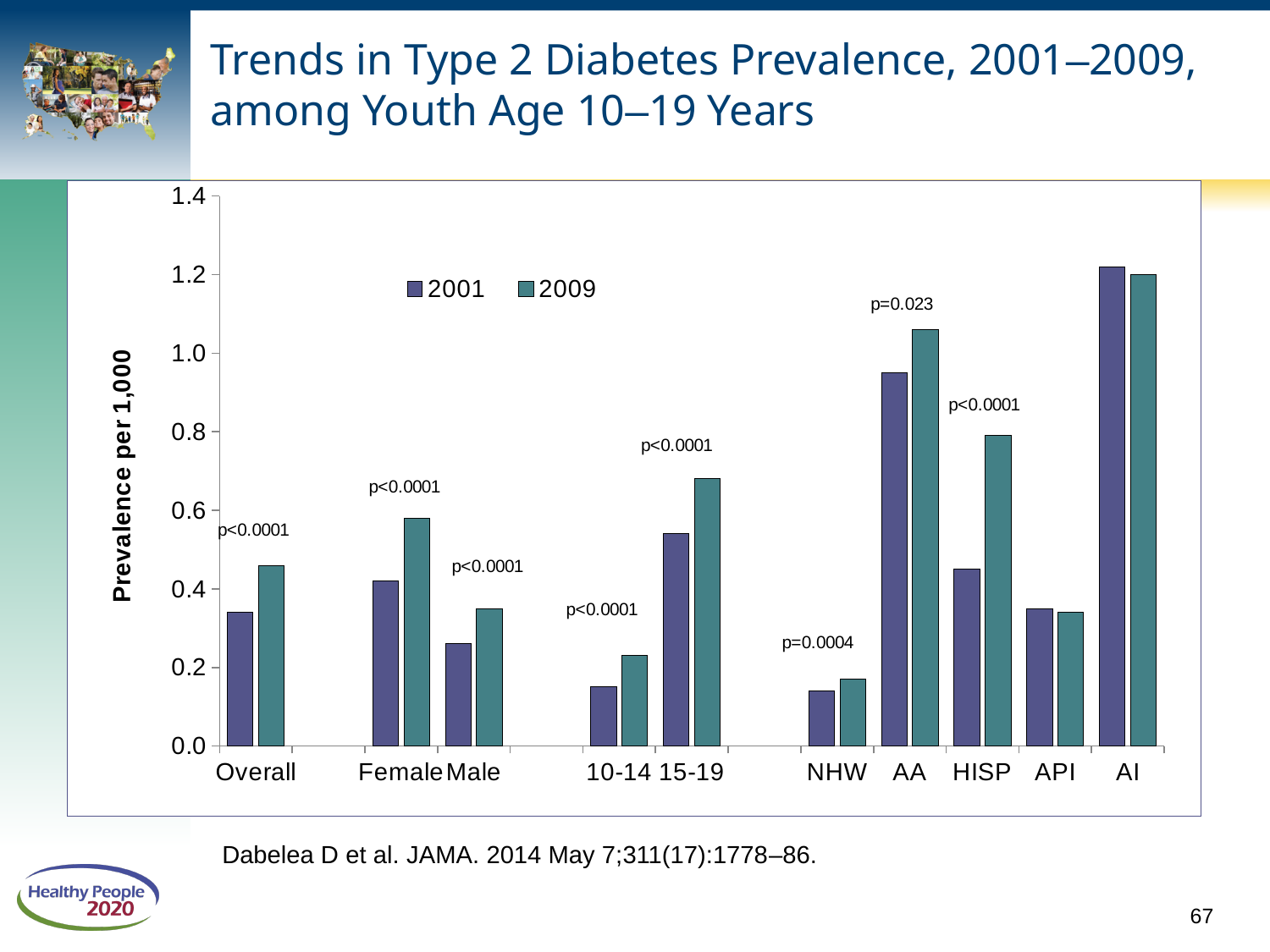
How many series does the legend list? 2 What is the label on the y axis? Prevalence per 1,000 How many categories are shown on the x axis? 10 What p-value is printed above the AA bars? p=0.023 What kind of chart is shown on the slide? Bar chart Which category has the highest 2009 value? AI Which category has the highest 2001 value? AI Is the 2009 value for Overall greater or less than 0.4? greater Is the 2001 value for NHW greater or less than 0.2? less Is the 2009 value for 15-19 greater or less than 0.6? greater Which is larger, the 2009 value for Female or the 2009 value for Male? Female Which is larger, the 2009 value for AA or the 2009 value for HISP? AA